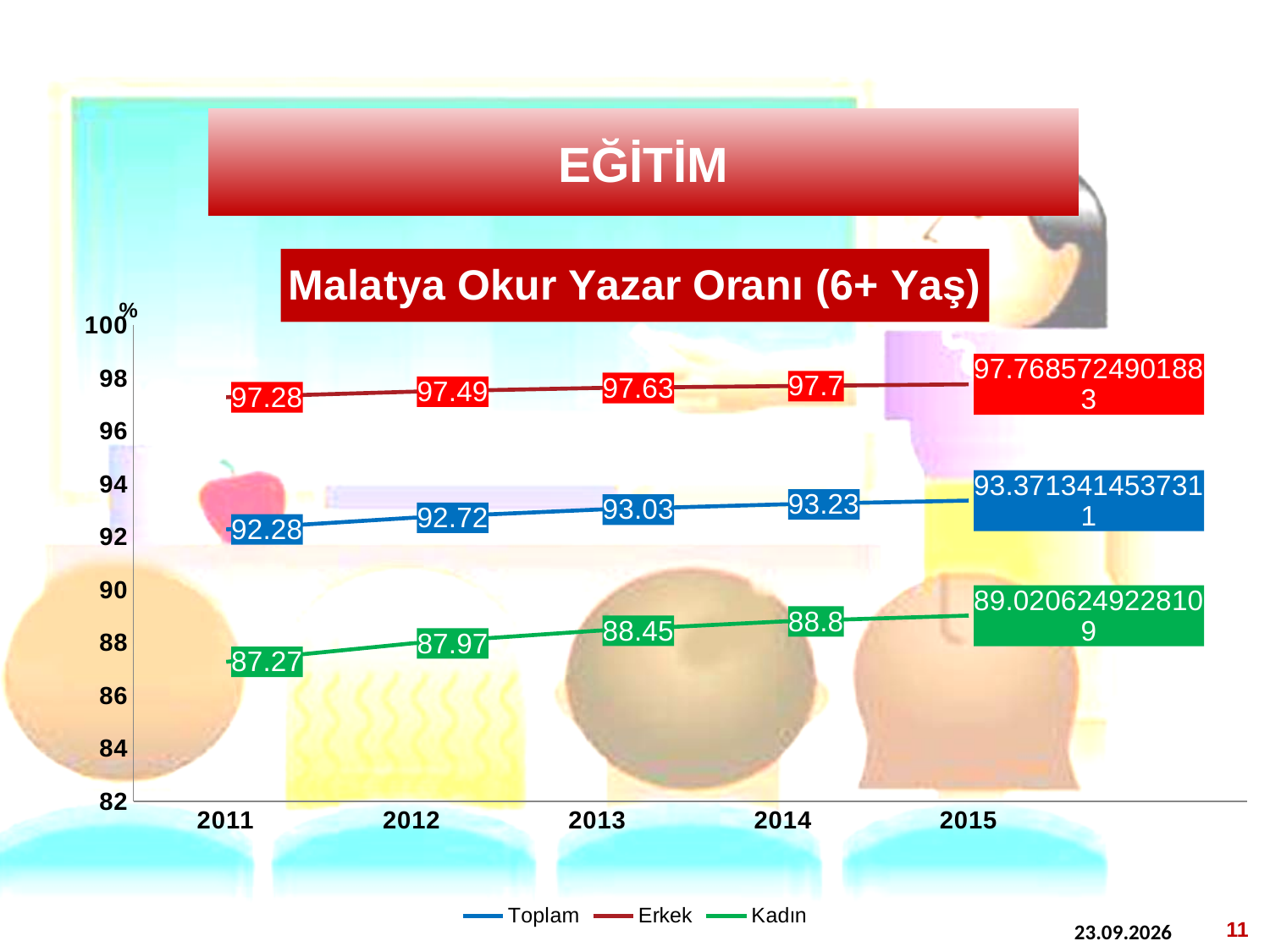
Which series has the lowest value in 2011? Kadın Which series has the highest values across all years? Erkek What type of chart is shown on the slide? line chart What is the difference between the Erkek and Kadın values in 2014? 8.9 What is the title of the chart? Malatya Okur Yazar Oranı (6+ Yaş) How many years are shown on the x axis? 5 What is the Toplam value for 2013? 93.03 How many series does the legend list? 3 What is the Erkek value for 2011? 97.28 Does the Kadın series rise or fall from 2011 to 2015? rise What is the Kadın value for 2012? 87.97 What is the Kadın value for 2014? 88.8